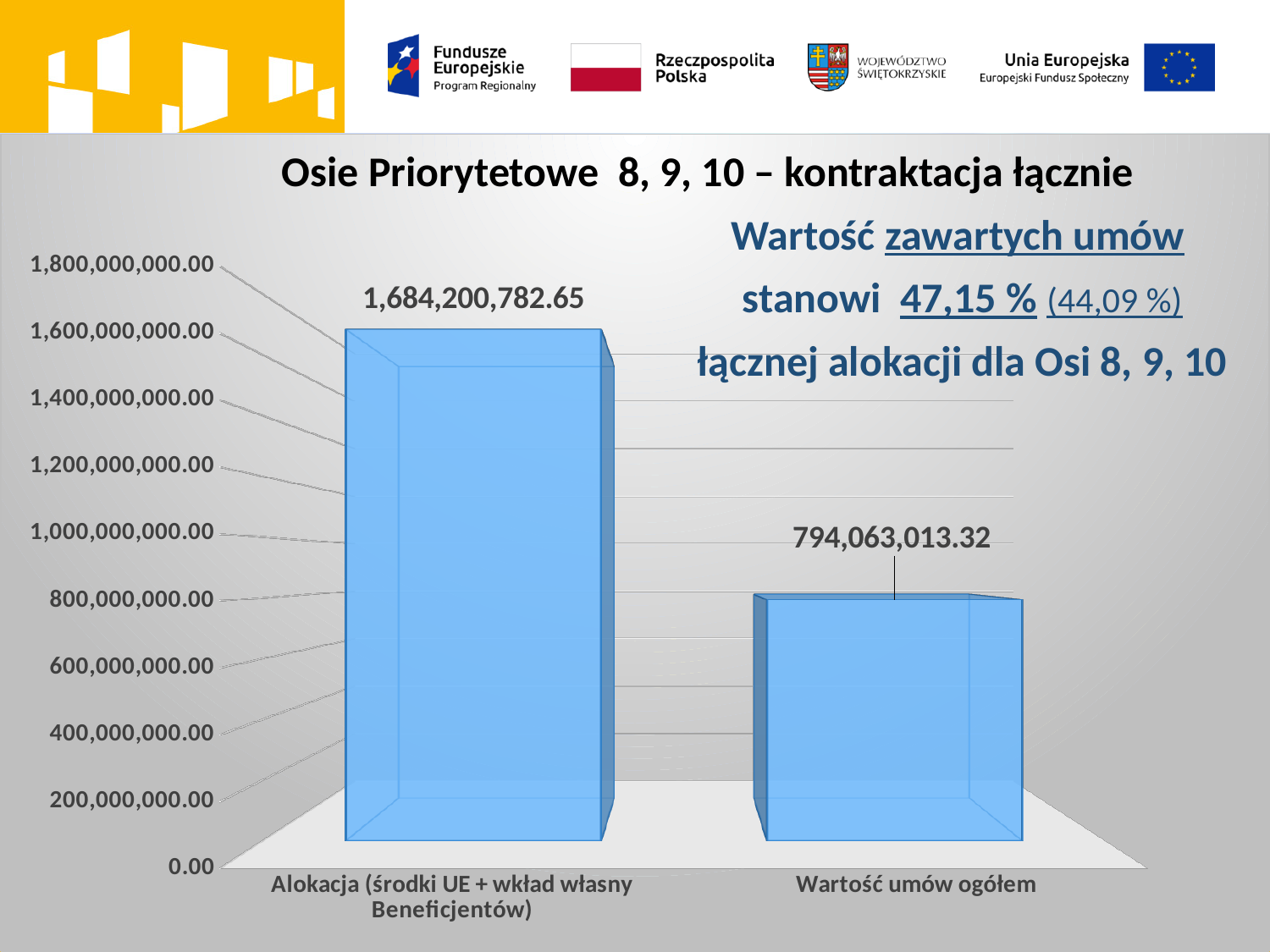
What is the title of the slide containing the chart? Osie Priorytetowe 8, 9, 10 – kontraktacja łącznie What is the value for "Alokacja (środki UE + wkład własny Beneficjentów)"? 1,684,200,782.65 Which is larger: the value for "Alokacja (środki UE + wkład własny Beneficjentów)" or the value for "Wartość umów ogółem"? Alokacja (środki UE + wkład własny Beneficjentów) Which category has the lowest value? Wartość umów ogółem Is the value for "Alokacja (środki UE + wkład własny Beneficjentów)" greater or less than 1,600,000,000.00? greater What is the difference between the value for "Alokacja (środki UE + wkład własny Beneficjentów)" and the value for "Wartość umów ogółem"? 890,137,769.33 Which category has the highest value? Alokacja (środki UE + wkład własny Beneficjentów) Is the value for "Wartość umów ogółem" greater or less than 1,000,000,000.00? less How many categories are shown on the chart? 2 What kind of chart is shown on the slide? bar chart According to the text next to the chart, what percentage of the total allocation does the value of concluded contracts represent? 47,15 % What is the value for "Wartość umów ogółem"? 794,063,013.32